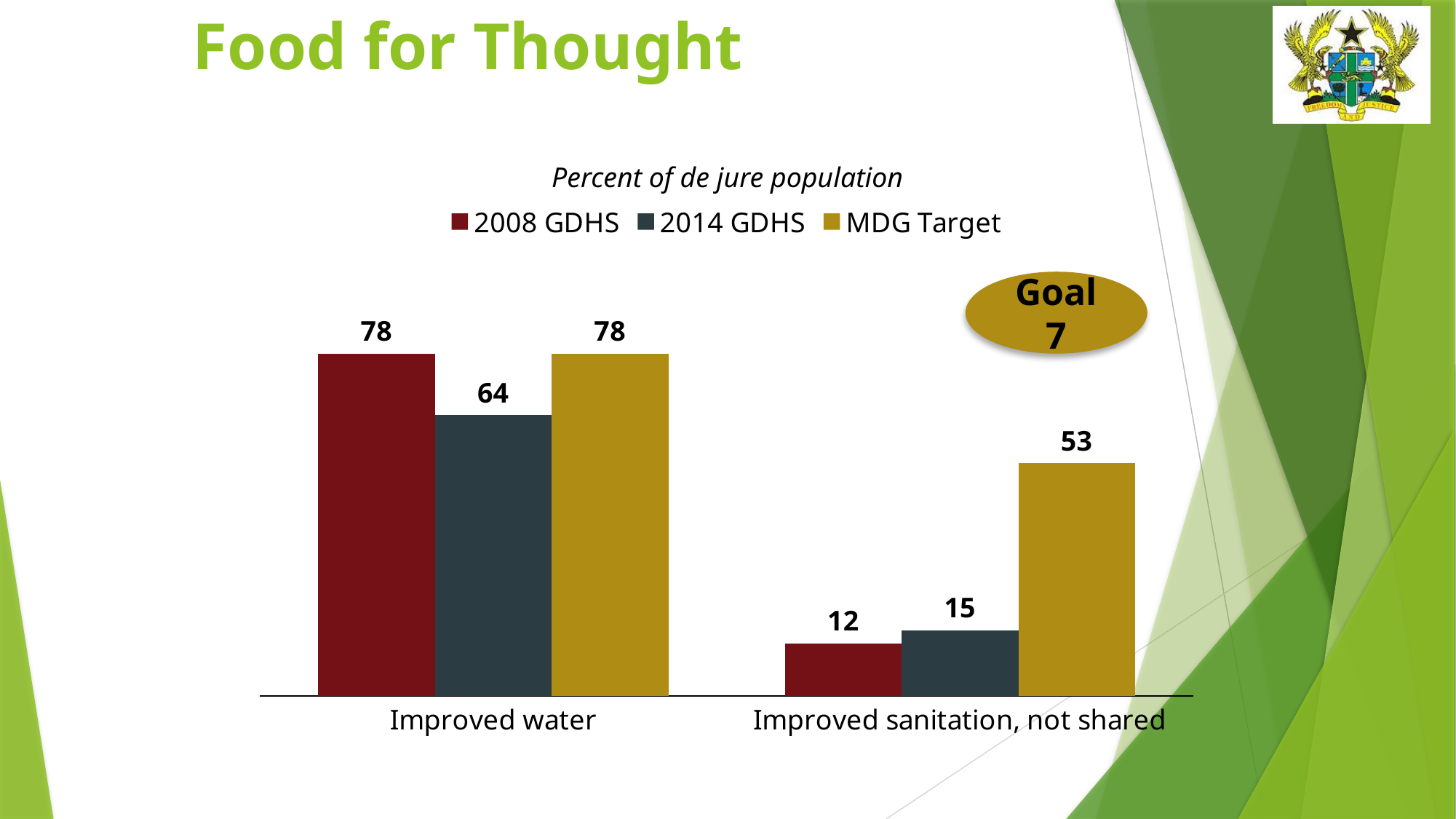
What is the 2014 GDHS value for Improved sanitation, not shared? 15 What is the difference between the 2008 GDHS and 2014 GDHS values for Improved water? 14 Which is larger for Improved sanitation, not shared: the 2008 GDHS value or the 2014 GDHS value? 2014 GDHS What type of chart is shown on the slide? Bar chart What is the MDG Target value for Improved sanitation, not shared? 53 Which series has the lowest value for Improved water? 2014 GDHS How many series does the legend list? 3 What is the 2008 GDHS value for Improved sanitation, not shared? 12 What is the difference between the MDG Target and the 2014 GDHS value for Improved sanitation, not shared? 38 Which series has the lowest value for Improved sanitation, not shared? 2008 GDHS How many categories are shown on the x axis? 2 What is the 2014 GDHS value for Improved water? 64